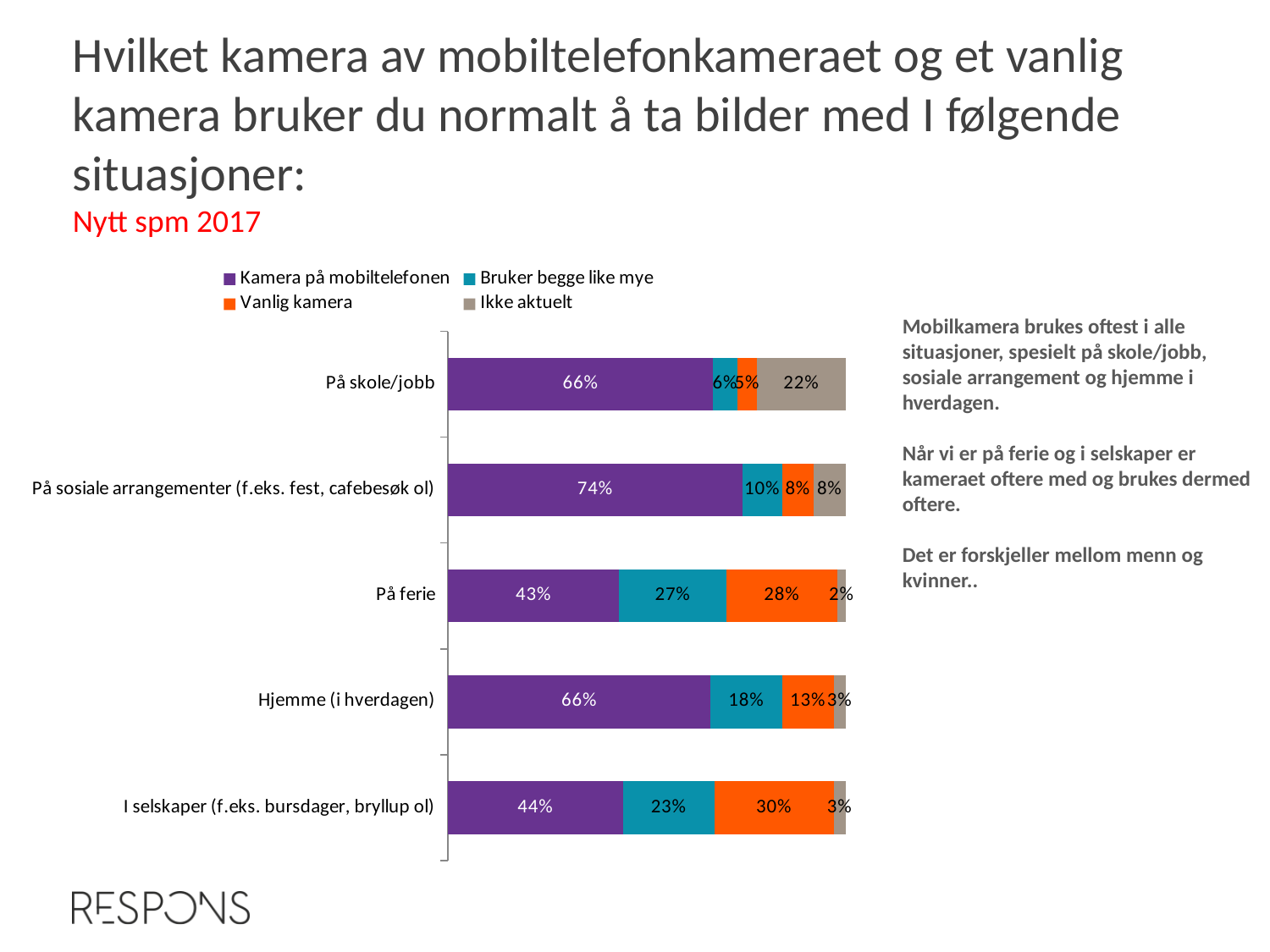
Which category has the lowest value for 'Vanlig kamera'? På skole/jobb What is the difference between the 'Vanlig kamera' values for 'På ferie' and 'Hjemme (i hverdagen)'? 15% Which category has the highest value for 'Kamera på mobiltelefonen'? På sosiale arrangementer (f.eks. fest, cafebesøk ol) What is the value for 'Ikke aktuelt' in the 'På skole/jobb' category? 22% Which series is shown in orange in the legend? Vanlig kamera How many series does the legend list? 4 What is the value for 'Vanlig kamera' in the 'I selskaper (f.eks. bursdager, bryllup ol)' category? 30% Which is larger: the 'Bruker begge like mye' value for 'På ferie' or for 'I selskaper (f.eks. bursdager, bryllup ol)'? På ferie What is the value for 'Bruker begge like mye' in the 'Hjemme (i hverdagen)' category? 18% What is the value for 'Kamera på mobiltelefonen' in the 'På ferie' category? 43% How many categories (situations) are shown in the chart? 5 What kind of chart is shown on the slide? stacked bar chart